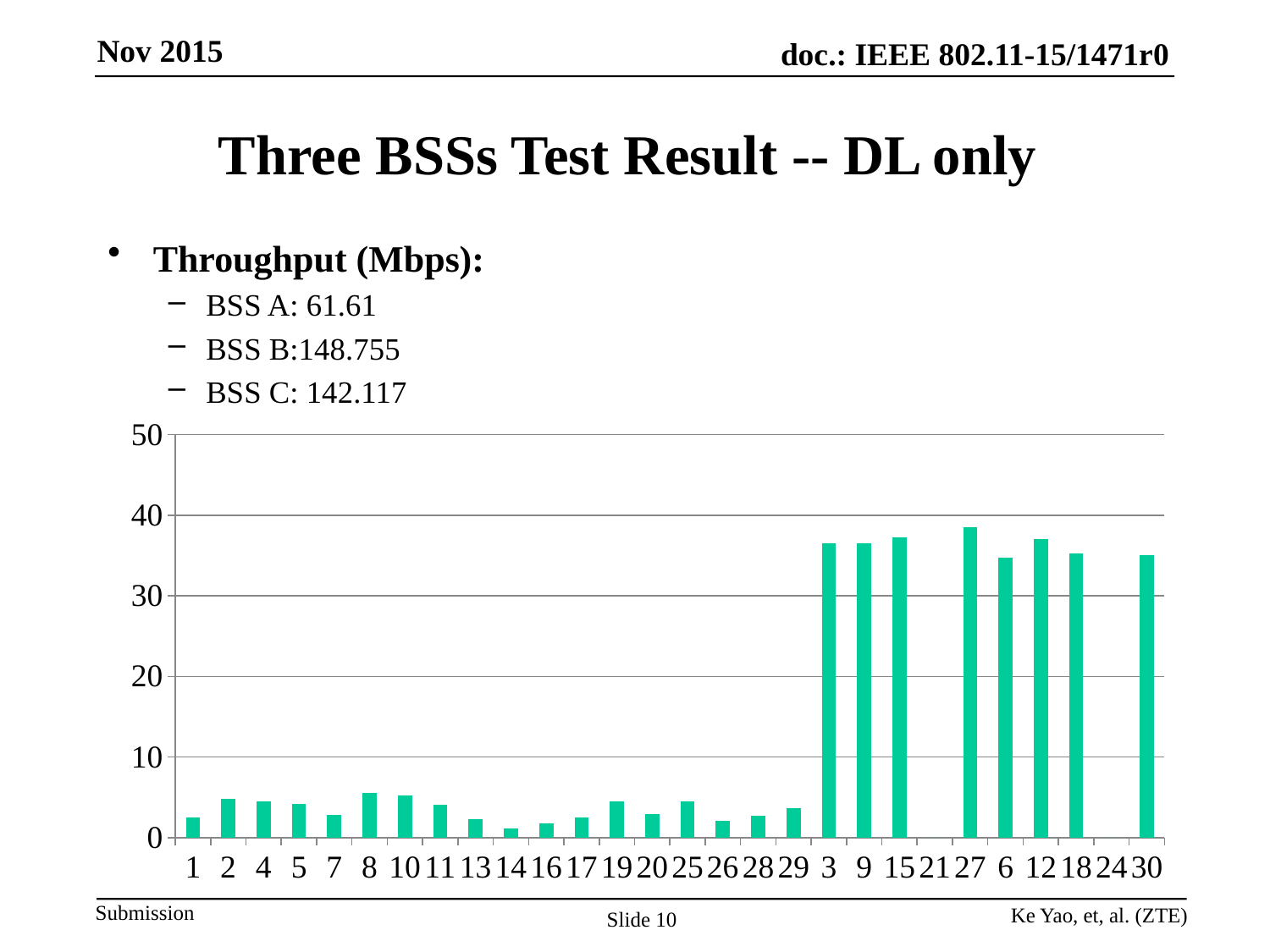
How many categories are labelled on the x axis of the chart? 28 Is the value for category 27 greater or less than 30? greater Which has the larger value, category 1 or category 3? 3 Which has the larger value, category 8 or category 14? 8 What colour are the bars in the chart? green Is the value for category 3 greater or less than 30? greater Is the value for category 8 greater or less than 10? less Which category has the tallest bar in the chart? 27 What is the highest value shown on the y axis of the chart? 50 What kind of chart is shown on the slide? bar chart